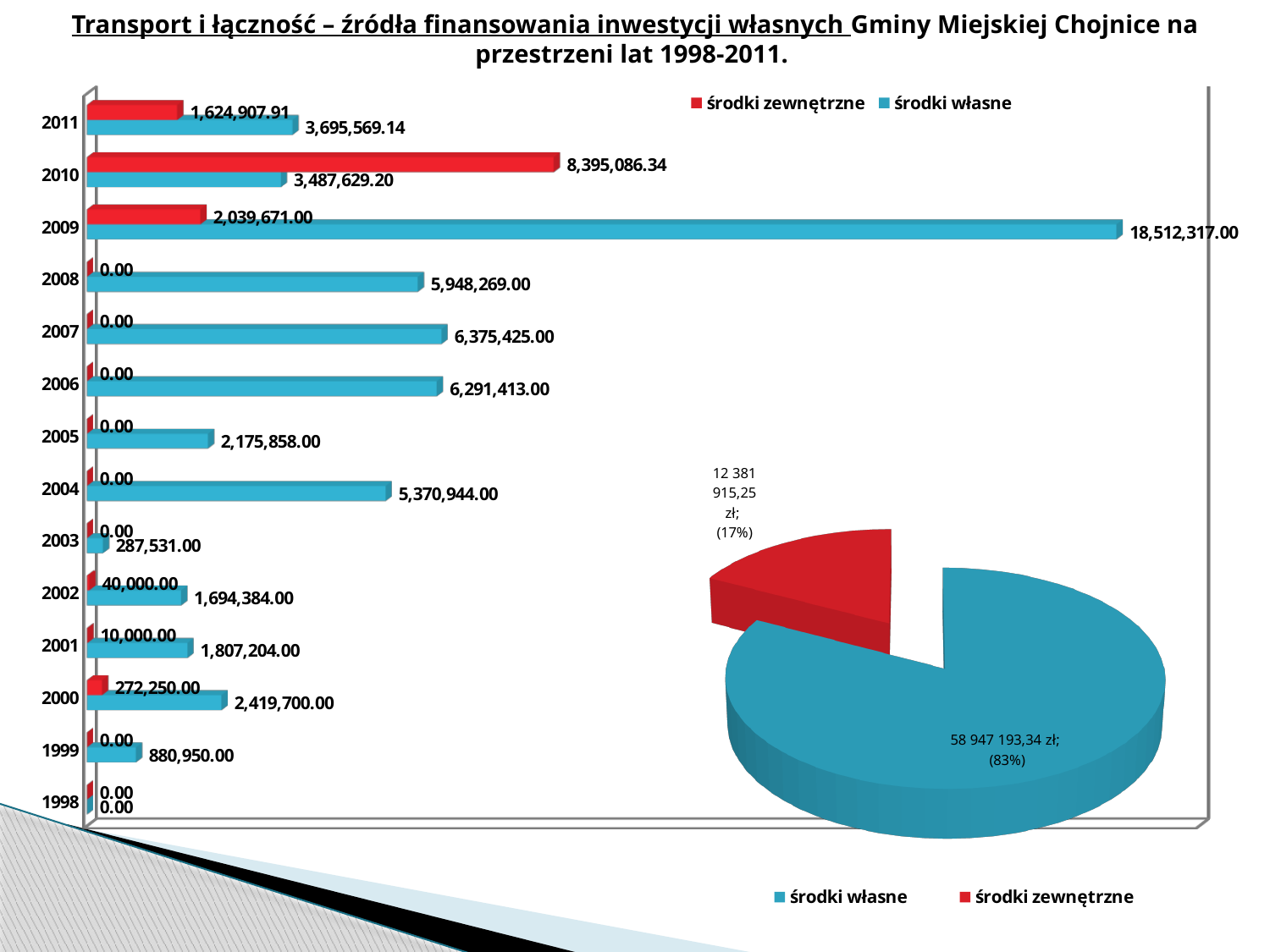
How many series does the bar chart's legend list? 2 In the pie chart, what share does środki własne have? 83% In the bar chart, what is the value of środki własne for 2005? 2,175,858.00 In the bar chart, which is larger in 2011: środki zewnętrzne or środki własne? środki własne In the bar chart, which year has the highest value of środki zewnętrzne? 2010 In the bar chart, which year has the highest value of środki własne? 2009 How many years are shown in the bar chart? 14 In the bar chart, what is the value of środki zewnętrzne for 2010? 8,395,086.34 What type of chart is the chart on the left side of the slide? bar chart In the bar chart, what is the value of środki własne for 2009? 18,512,317.00 In the bar chart, what is the value of środki zewnętrzne for 2000? 272,250.00 In the bar chart, what is the difference between środki zewnętrzne and środki własne in 2010? 4,907,457.14